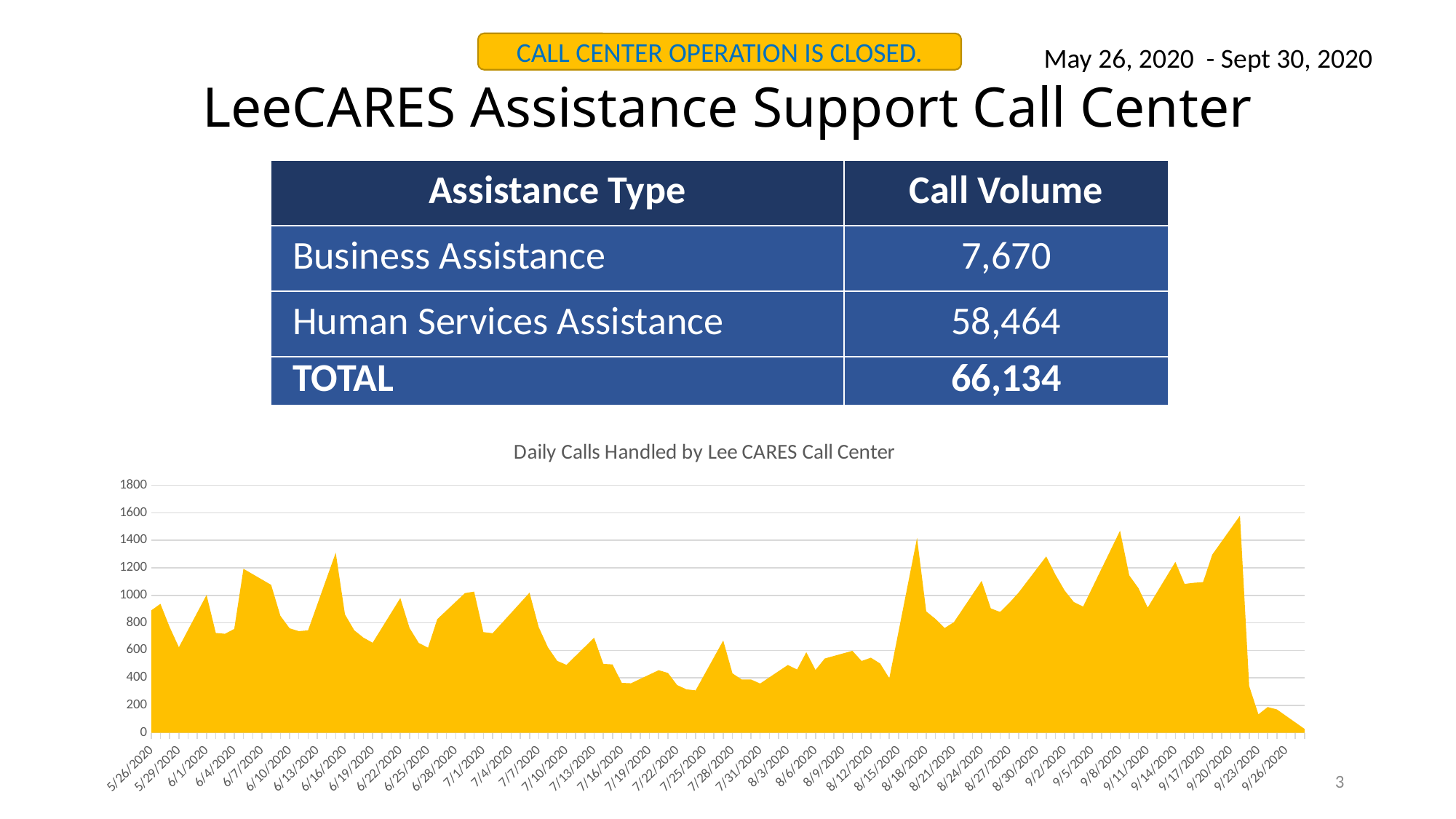
What is the highest value shown on the chart's vertical axis? 1800 Is the value for 9/26/2020 greater or less than 200? less Do the daily call values rise or fall between 9/20/2020 and 9/26/2020? fall Which is larger, the value for 9/20/2020 or the value for 9/26/2020? 9/20/2020 What is the title of the chart at the bottom of the slide? Daily Calls Handled by Lee CARES Call Center How many data series are plotted in the Daily Calls Handled chart? 1 Is the value for 7/19/2020 greater or less than 600? less Is the value for 8/3/2020 greater or less than 800? less In which month does the highest peak of the Daily Calls Handled chart occur? September What kind of chart is shown at the bottom of the slide? Area chart